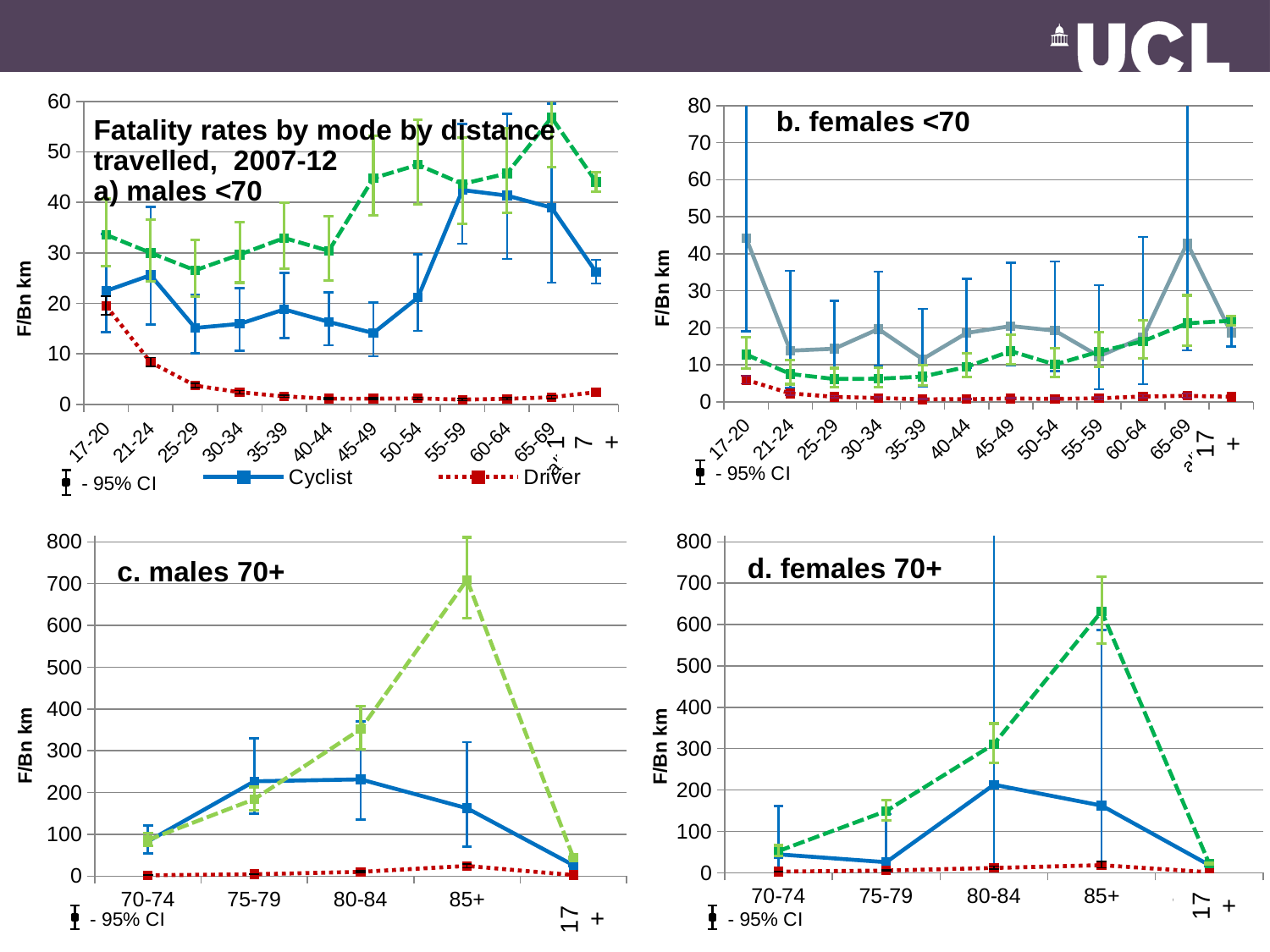
In chart c. males 70+, how many age categories are shown on the x axis? 5 In chart a) males <70, is the Cyclist value for 55-59 greater or less than 30? greater In chart d. females 70+, is the dashed green line value for 85+ greater or less than 500? greater In chart a) males <70, is the Driver value for 25-29 greater or less than 10? less What is the y-axis label on chart c. males 70+? F/Bn km What kind of chart is used in panel a) males <70? line chart In chart a) males <70, which is larger for Cyclist: the value at 45-49 or at 55-59? 55-59 In chart c. males 70+, at which age category does the dashed green line reach its highest value? 85+ In chart a) males <70, does the Driver line rise or fall from 17-20 to 25-29? fall In chart a) males <70, which two travel modes are named in the legend? Cyclist and Driver